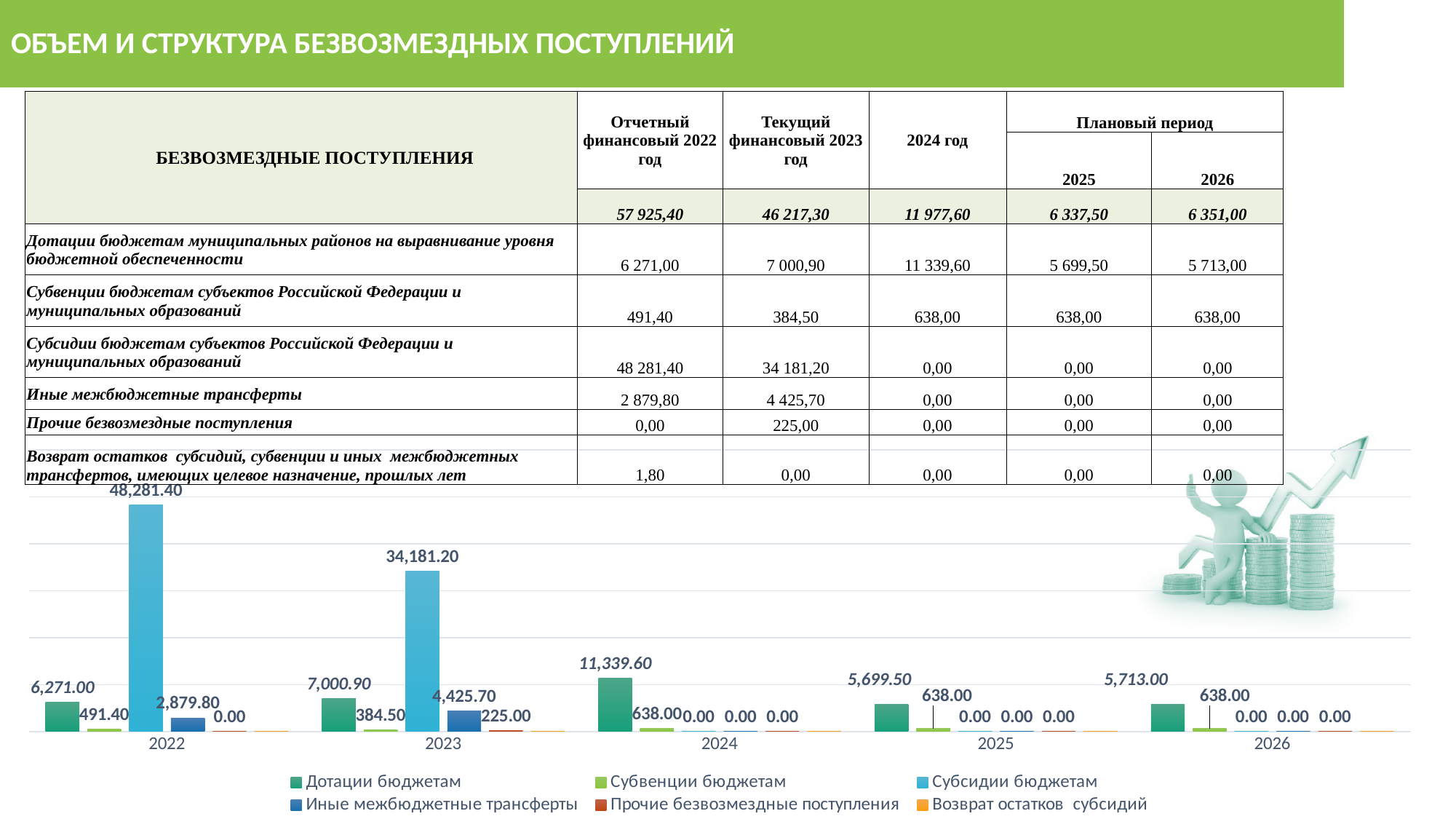
What is the value of Иные межбюджетные трансферты for 2023 in the chart? 4,425.70 Which year has the highest value for Дотации бюджетам in the chart? 2024 What is the value of Субвенции бюджетам for 2025 in the chart? 638.00 Which year has the highest value for Субсидии бюджетам in the chart? 2022 How many series does the chart legend list? 6 How many year categories are shown on the x axis of the chart? 5 Which is larger in the chart: Дотации бюджетам for 2025 or for 2026? 2026 What type of chart is shown at the bottom of the slide? Bar chart What is the difference between the Субсидии бюджетам values for 2022 and 2023 in the chart? 14,100.20 What is the value of Субсидии бюджетам for 2022 in the chart? 48,281.40 Do the Субсидии бюджетам values rise or fall from 2022 to 2024 in the chart? Fall What is the value of Дотации бюджетам for 2024 in the chart? 11,339.60